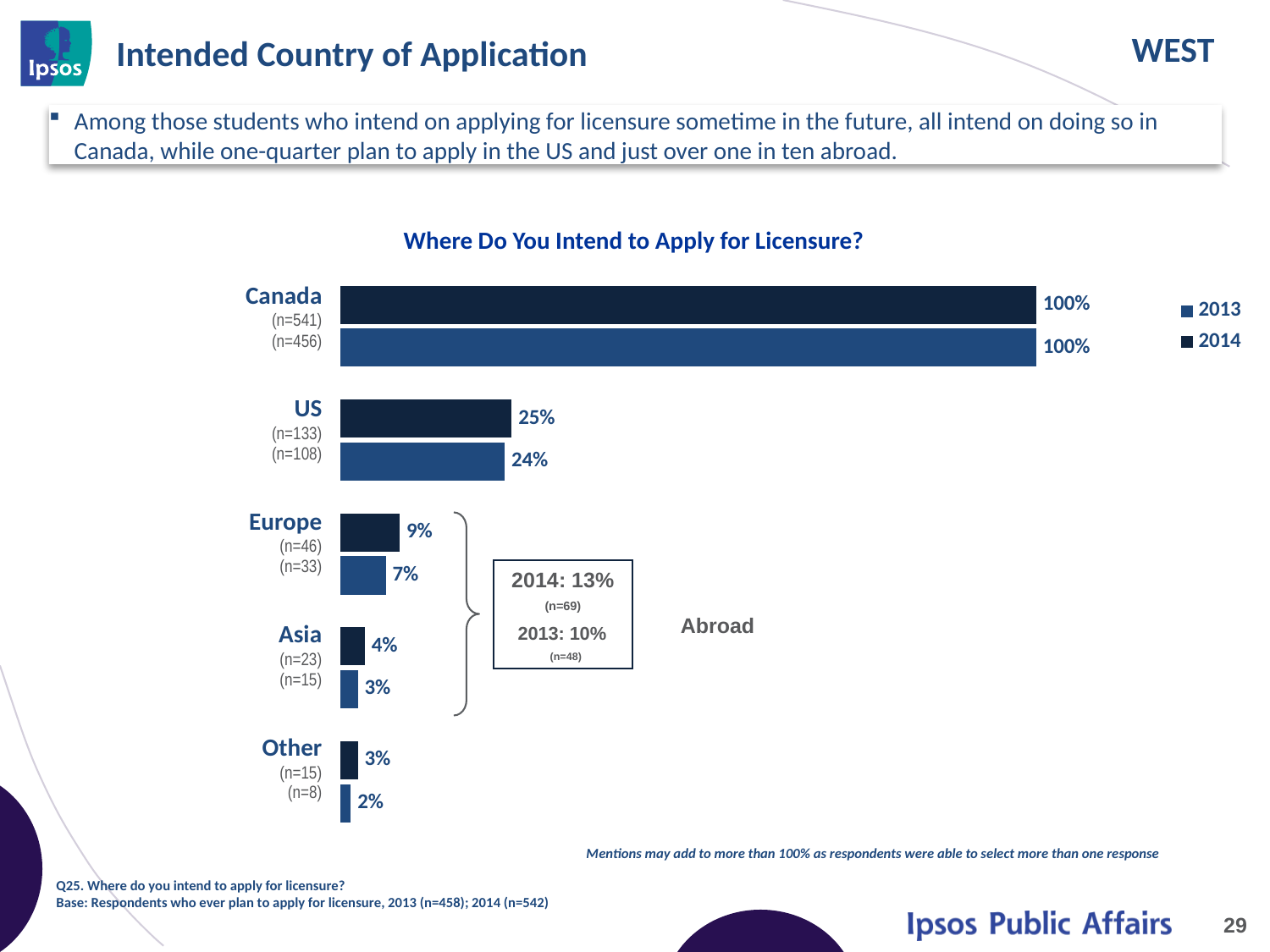
What value is shown on the lighter blue (2014) bar for US? 24% How many series does the chart legend list? 2 How many countries/regions are shown as categories in the chart? 5 What is the title of the chart? Where Do You Intend to Apply for Licensure? Which is larger for Other: the dark navy (2013) bar or the lighter blue (2014) bar? dark navy (2013) What type of chart is shown on the slide? bar chart What value is shown on the dark navy (2013) bar for US? 25% Which category has the lowest values in the chart? Other Which category has the highest values in the chart? Canada What value is shown on the dark navy (2013) bar for Europe? 9% What value is shown on the lighter blue (2014) bar for Asia? 3% What is the difference between the dark navy (2013) bar and the lighter blue (2014) bar for Europe? 2%